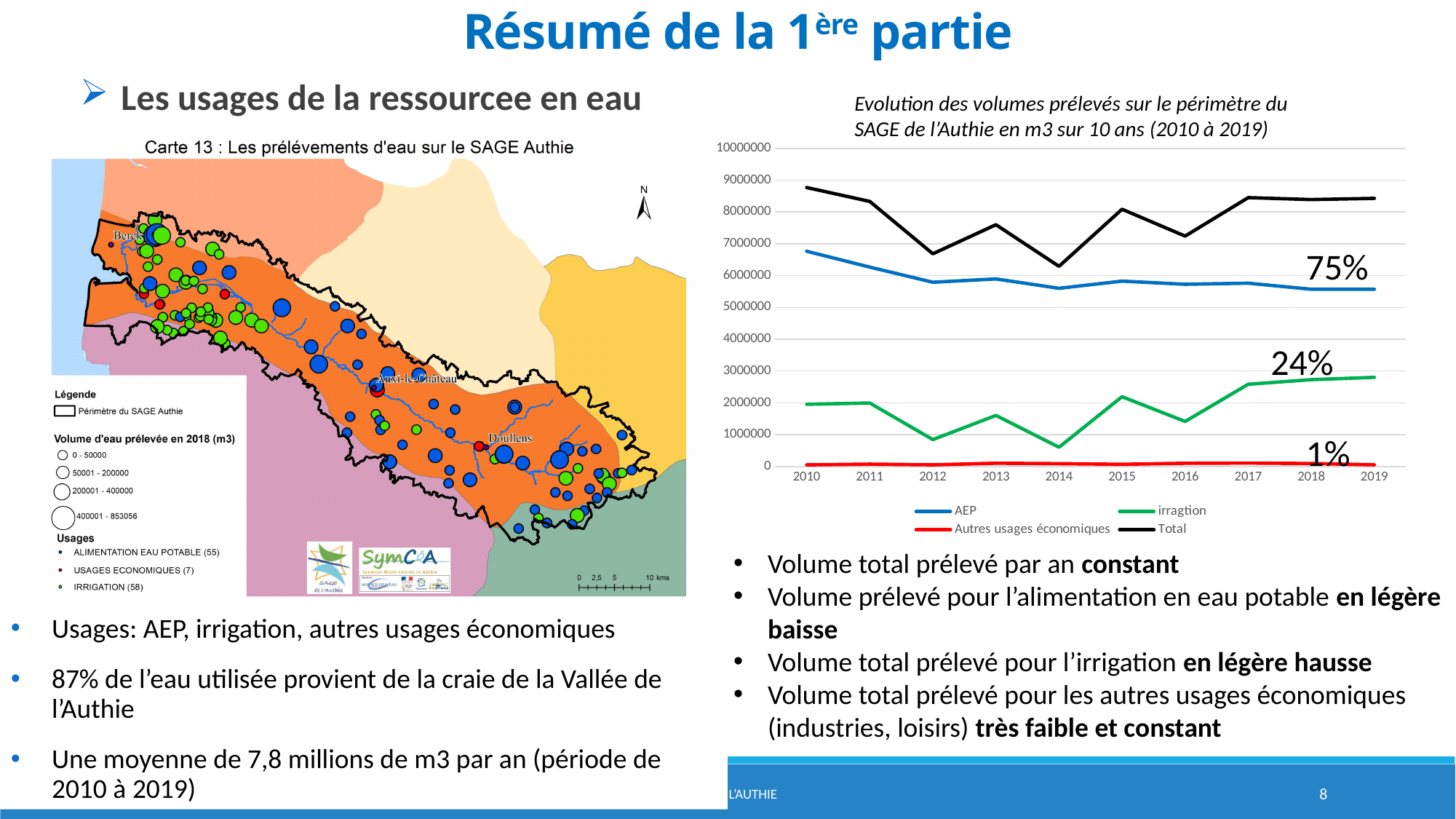
How many years are plotted along the x axis of the line chart? 10 How many series does the legend of the line chart list? 4 Is the irragtion value for 2019 greater or less than 2000000? greater What percentage label is printed next to the AEP line in the chart? 75% Does the AEP series generally rise or fall from 2010 to 2019? fall In which year is the AEP series at its highest in the line chart? 2010 In 2015, which is larger in the line chart: AEP or irragtion? AEP What kind of chart is shown on the right of the slide? line chart Is the AEP value for 2010 greater or less than 6000000? greater In which year is the Total series at its lowest in the line chart? 2014 Is the Total value for 2014 greater or less than 7000000? less Which series has the highest values across all years in the line chart? Total